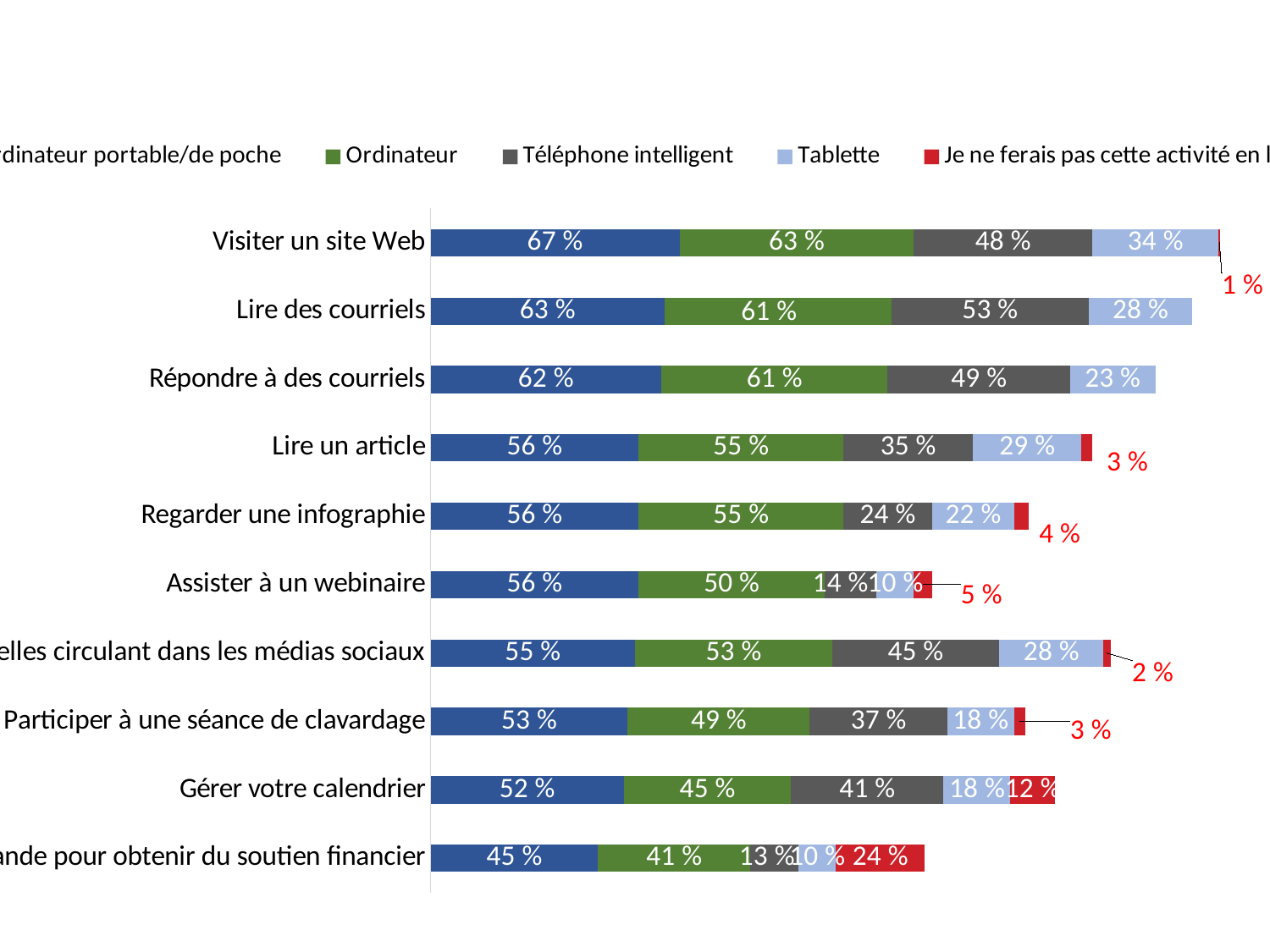
For Visiter un site Web, what is the difference between the Ordinateur value and the Téléphone intelligent value? 15 percentage points For Lire un article, what is the difference between the Téléphone intelligent value and the Tablette value? 6 percentage points What kind of chart is shown on the slide? Stacked bar chart How many series does the legend list? 5 Which category has the highest Téléphone intelligent value? Lire des courriels What is the Tablette value for Visiter un site Web? 34 % Which category has the highest Tablette value? Visiter un site Web For Regarder une infographie, which is larger: the Téléphone intelligent value or the Tablette value? Téléphone intelligent What is the value of the red series for Gérer votre calendrier? 12 % What is the Ordinateur value for Lire des courriels? 61 % What is the Téléphone intelligent value for Gérer votre calendrier? 41 % How many categories (activities) are shown on the chart? 10